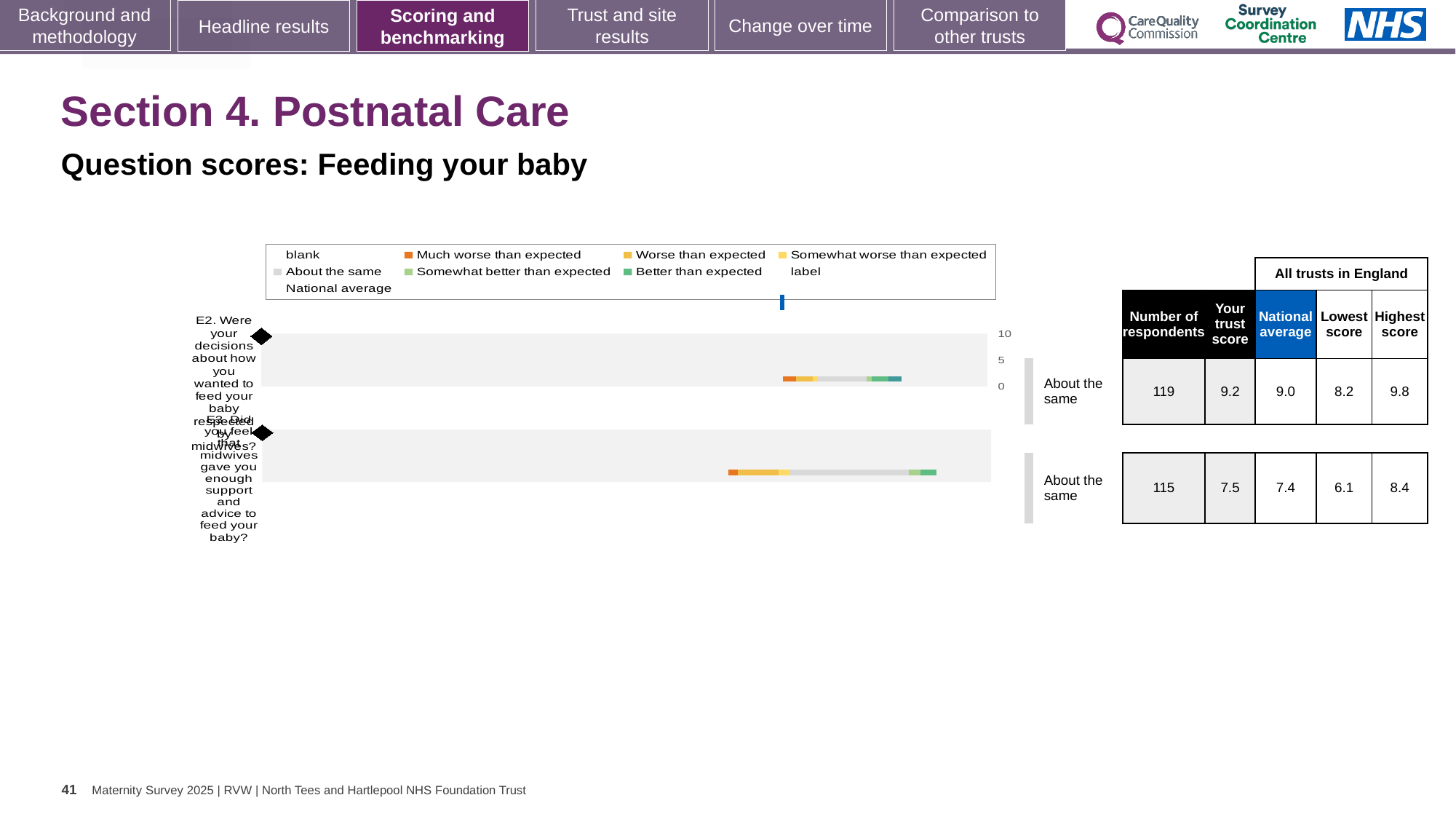
What is the trust score for question E2 about decisions on how you wanted to feed your baby being respected by midwives? 9.2 What kind of chart is used to show the question scores for Feeding your baby? bar chart How many respondents answered question E2? 119 What is the highest score among all trusts in England for question E3? 8.4 What is the trust score for question E3 about midwives giving enough support and advice to feed your baby? 7.5 Which question has the higher trust score, E2 or E3? E2 What is the difference between the trust scores for E2 and E3? 1.7 Which legend entry is shown in orange? Much worse than expected What is the national average for question E2? 9.0 How many questions (categories) are plotted on the chart? 2 What is the difference between the lowest score for E2 (8.2) and the lowest score for E3 (6.1)? 2.1 What benchmark category is shown next to both E2 and E3 on the chart? About the same